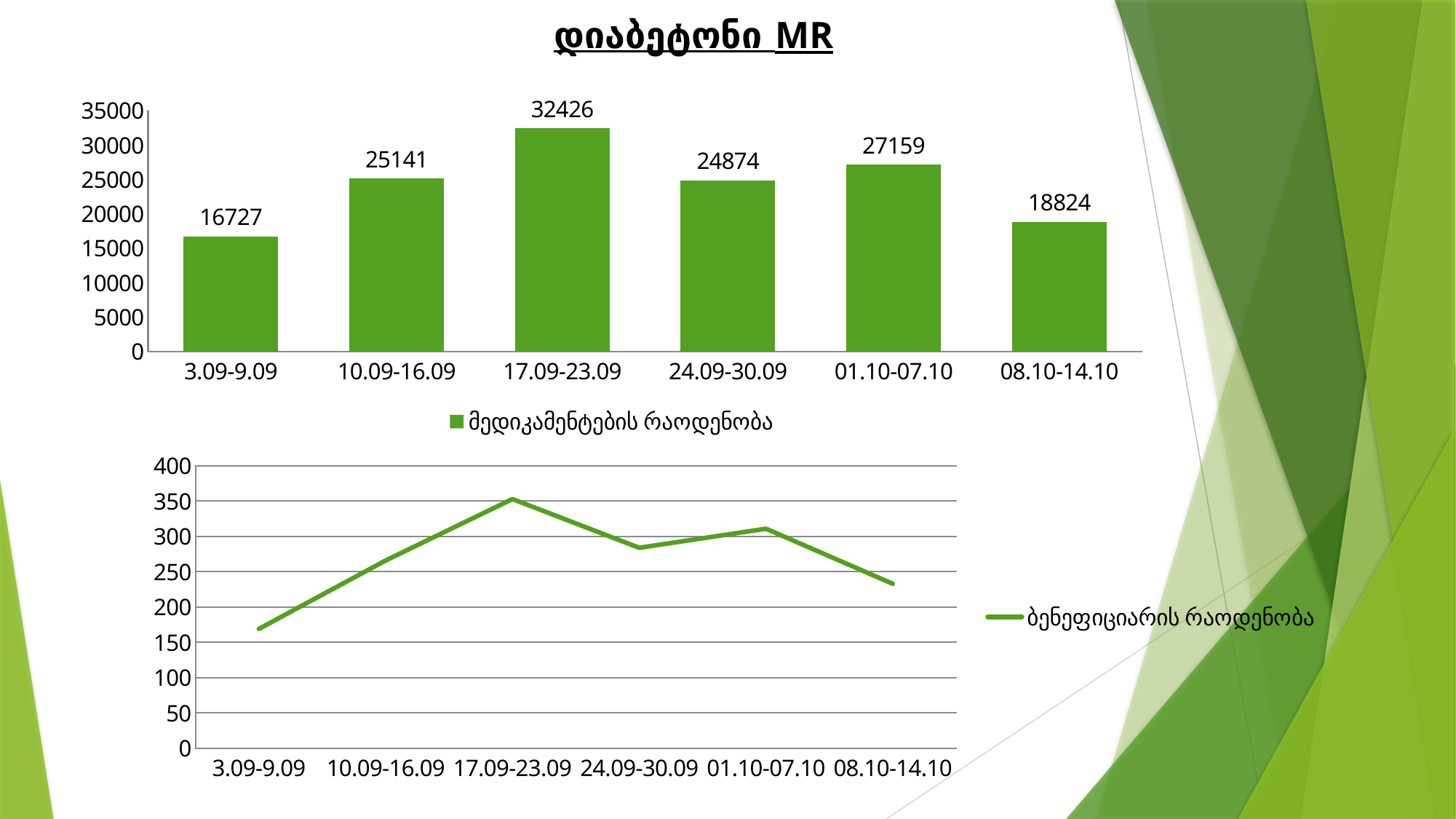
In the top bar chart, which period has the highest value? 17.09-23.09 In the top bar chart, what is the value for 3.09-9.09? 16727 In the top bar chart, what is the value for 17.09-23.09? 32426 How many bars are in the top bar chart? 6 In the top bar chart, which is larger: the value for 10.09-16.09 or the value for 24.09-30.09? 10.09-16.09 In the bottom line chart, which period has the highest value? 17.09-23.09 In the top bar chart, which period has the lowest value? 3.09-9.09 In the top bar chart, what is the difference between the values for 01.10-07.10 and 08.10-14.10? 8335 In the bottom line chart, is the value for 17.09-23.09 greater or less than 300? greater What is the title of the slide? დიაბეტონი MR In the bottom line chart, is the value for 3.09-9.09 greater or less than 200? less What type of chart is the bottom chart on the slide? line chart